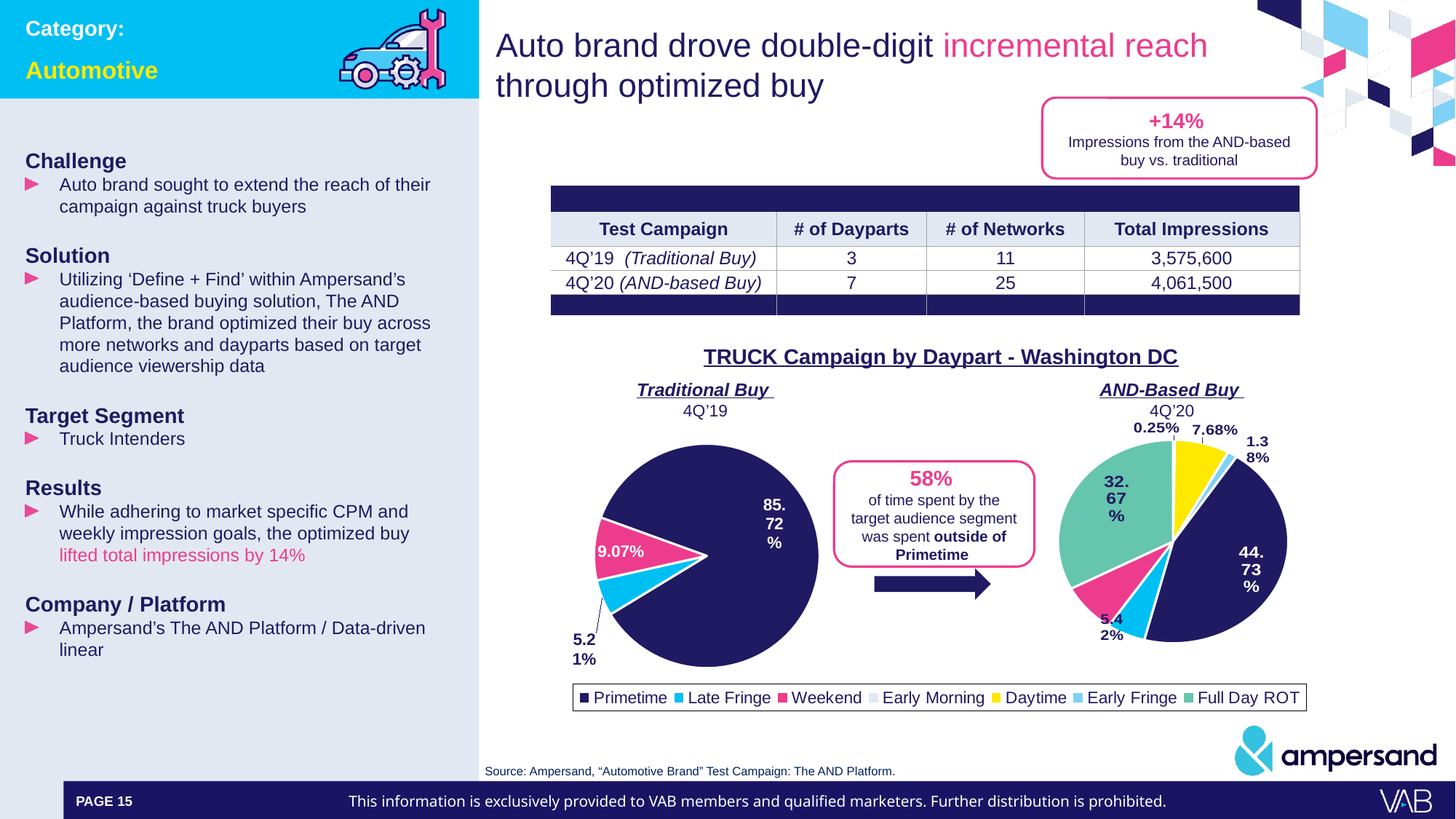
In the AND-Based Buy 4Q'20 pie chart, what share does Full Day ROT account for? 32.67% In the Traditional Buy 4Q'19 pie chart, which daypart has the smallest slice? Late Fringe What kind of charts are used to show the TRUCK Campaign by Daypart - Washington DC? Pie charts In the AND-Based Buy 4Q'20 pie chart, what share does Primetime account for? 44.73% In the AND-Based Buy 4Q'20 pie chart, which daypart has the largest slice? Primetime In the Traditional Buy 4Q'19 pie chart, what share does Late Fringe account for? 5.21% In the Traditional Buy 4Q'19 pie chart, what share does Primetime account for? 85.72% By how many percentage points is the Primetime share in the Traditional Buy 4Q'19 pie chart larger than in the AND-Based Buy 4Q'20 pie chart? 40.99 percentage points How many dayparts does the shared legend below the pie charts list? 7 In the AND-Based Buy 4Q'20 pie chart, what share does Daytime account for? 7.68% In the Traditional Buy 4Q'19 pie chart, what share does Weekend account for? 9.07%